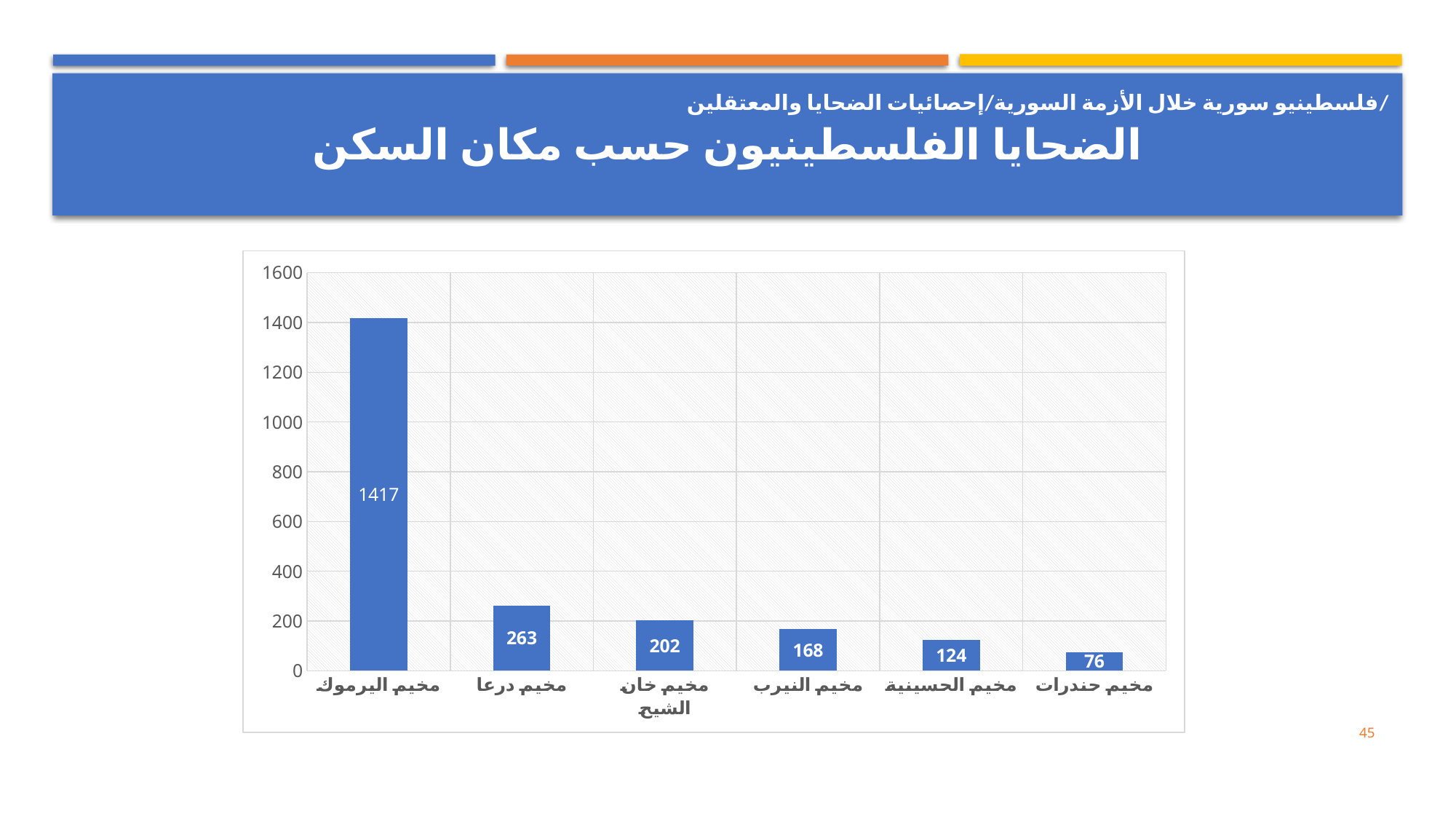
What kind of chart is shown on the slide? bar chart What is the value for مخيم الحسينية? 124 What is the difference between the values for مخيم درعا and مخيم النيرب? 95 What is the value for مخيم خان الشيخ? 202 How many categories are shown on the x axis? 6 Which category has the highest value? مخيم اليرموك Which category has the lowest value? مخيم حندرات What is the value for مخيم درعا? 263 Do the values rise or fall from left to right along the x axis? fall Which is larger, the value for مخيم خان الشيخ or the value for مخيم الحسينية? مخيم خان الشيخ What is the value for مخيم اليرموك? 1417 Is the value for مخيم حندرات greater or less than 200? less